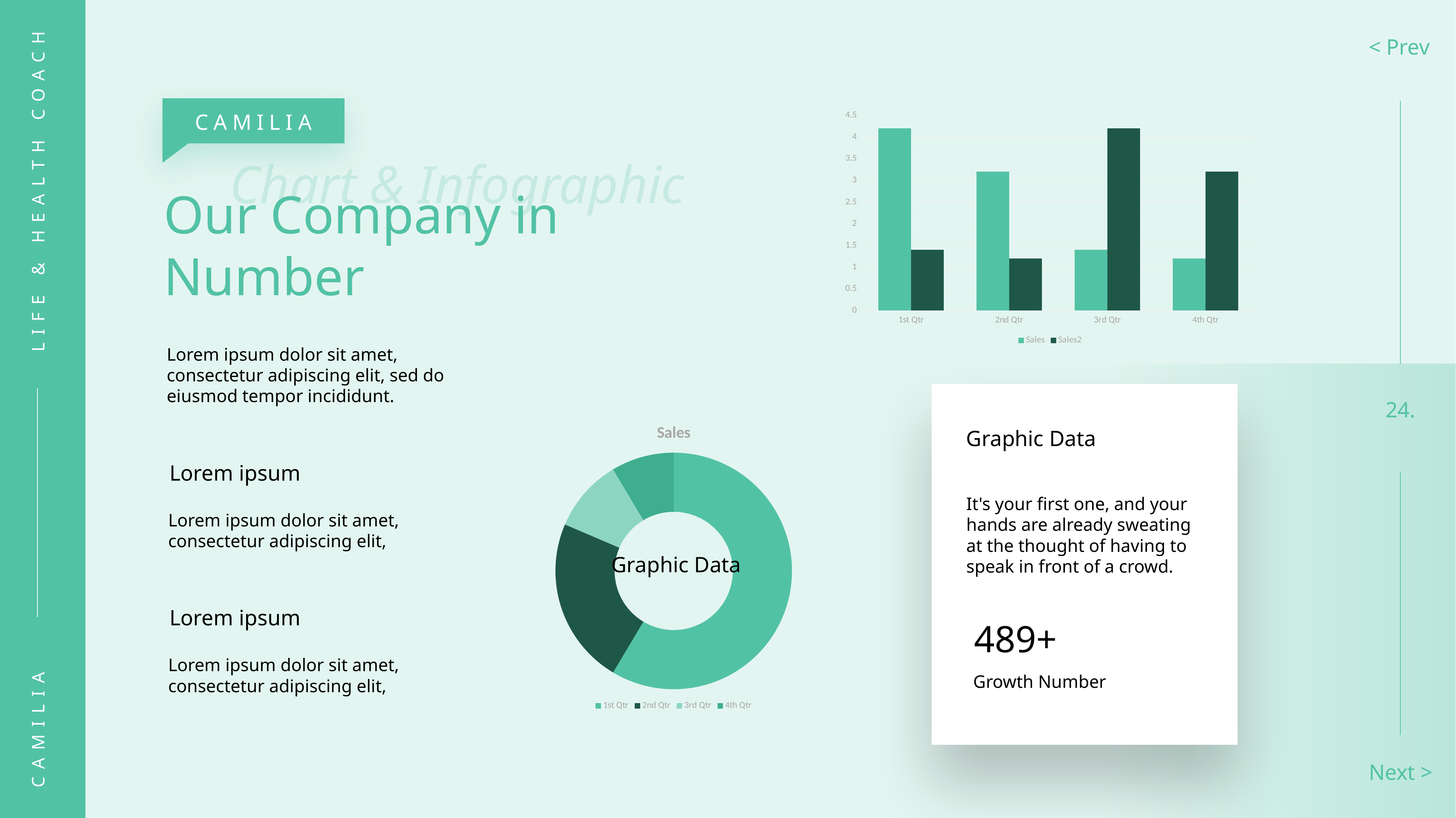
In the doughnut chart titled Sales, which quarter has the largest slice? 1st Qtr What kind of chart is the chart in the top right of the slide? bar chart In the bar chart in the top right, which quarter has the highest Sales value? 1st Qtr In the bar chart in the top right, which is larger for 2nd Qtr, Sales or Sales2? Sales In the bar chart in the top right, how many series does the legend list? 2 In the bar chart in the top right, do the Sales values rise or fall from 1st Qtr to 4th Qtr? fall In the bar chart in the top right, how many categories are shown on the x axis? 4 In the bar chart in the top right, which quarter has the highest Sales2 value? 3rd Qtr In the bar chart in the top right, is the Sales value for 1st Qtr greater or less than 4? greater In the bar chart in the top right, which quarter has the lowest Sales value? 4th Qtr In the bar chart in the top right, is the Sales2 value for 2nd Qtr greater or less than 1.5? less What is the title of the doughnut chart at the bottom centre of the slide? Sales